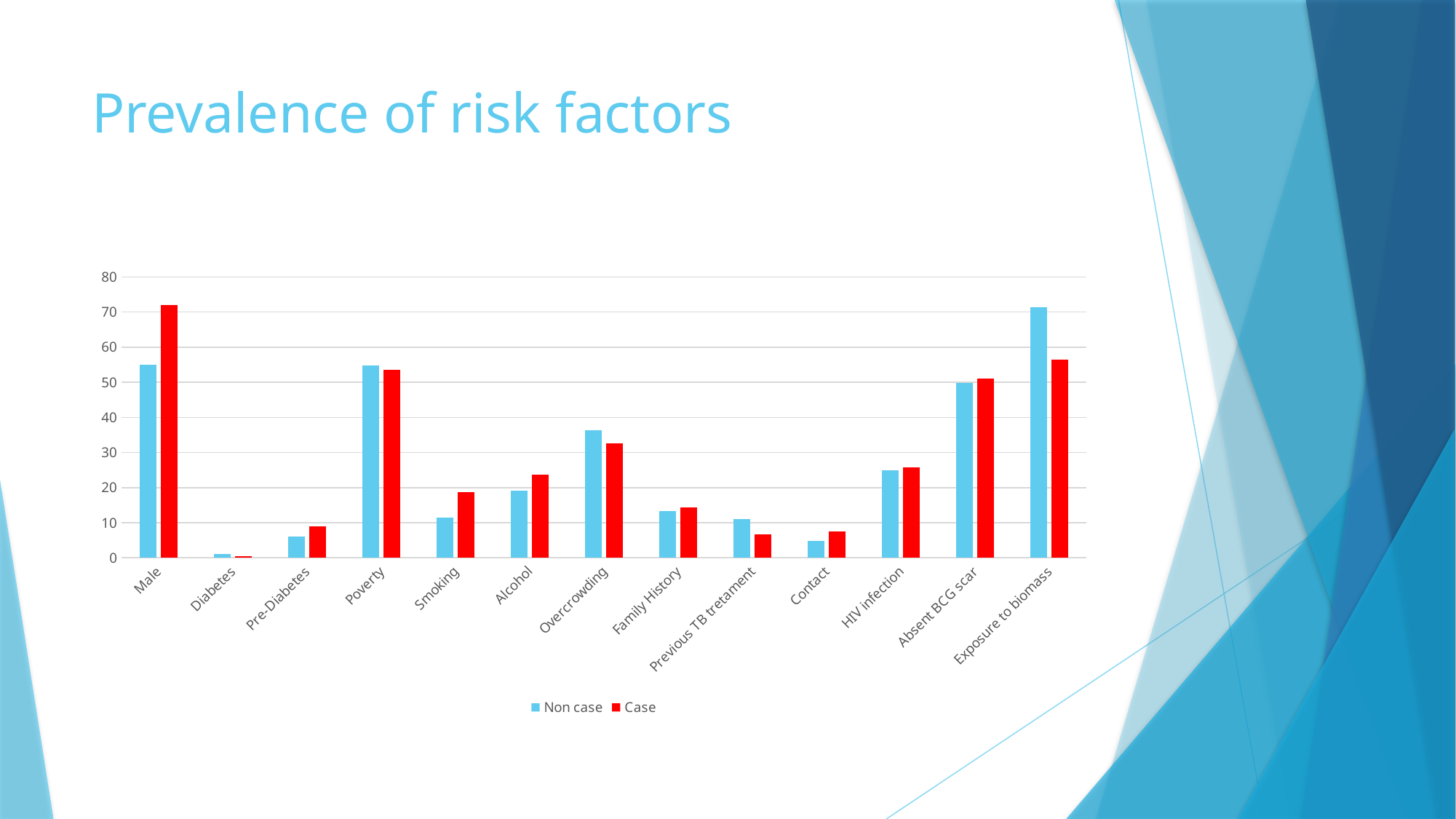
Is the Non case value for Overcrowding greater or less than 30? greater For Exposure to biomass, which is larger: the Non case value or the Case value? Non case What colour are the bars for the Case series? red For Alcohol, which is larger: the Non case value or the Case value? Case For Male, which is larger: the Non case value or the Case value? Case Which category has the lowest value for the Case series? Diabetes Is the Case value for Male greater or less than 60? greater Which category has the highest value for the Case series? Male What kind of chart is shown on the slide? bar chart How many risk factor categories are shown on the x axis? 13 How many series does the legend list? 2 Which category has the highest value for the Non case series? Exposure to biomass